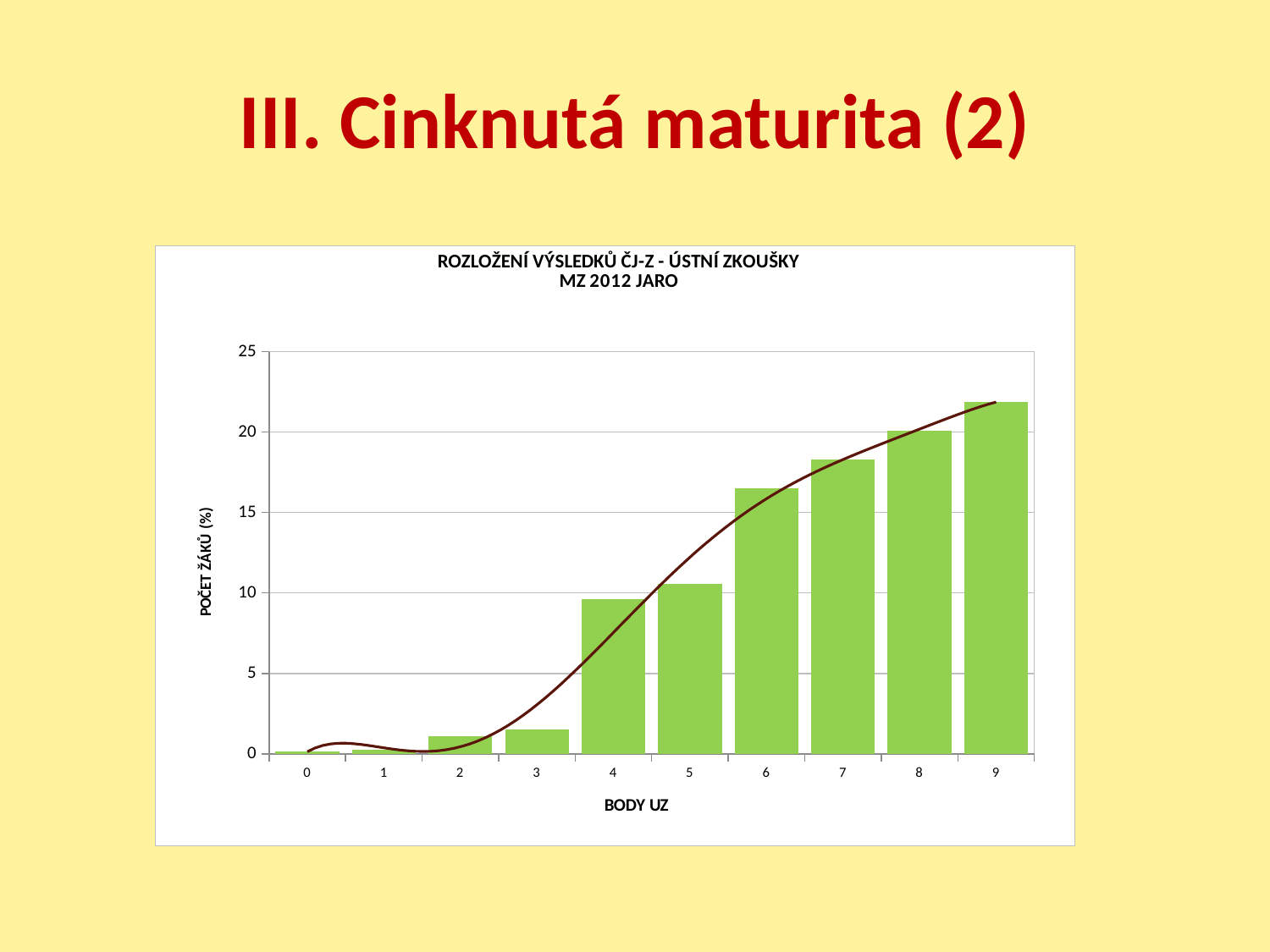
Do the bar values generally rise or fall as BODY UZ increases from 0 to 9? rise Is the value for BODY UZ 3 greater or less than 5? less Which has a larger value, BODY UZ 5 or BODY UZ 6? 6 What is the title of the chart? ROZLOŽENÍ VÝSLEDKŮ ČJ-Z - ÚSTNÍ ZKOUŠKY MZ 2012 JARO What is the label of the vertical axis? POČET ŽÁKŮ (%) Is the value for BODY UZ 6 greater or less than 15? greater Is the value for BODY UZ 9 greater or less than 20? greater What kind of chart is shown on the slide? bar chart How many bars (categories on the BODY UZ axis) does the chart show? 10 Which BODY UZ category has the highest POČET ŽÁKŮ (%)? 9